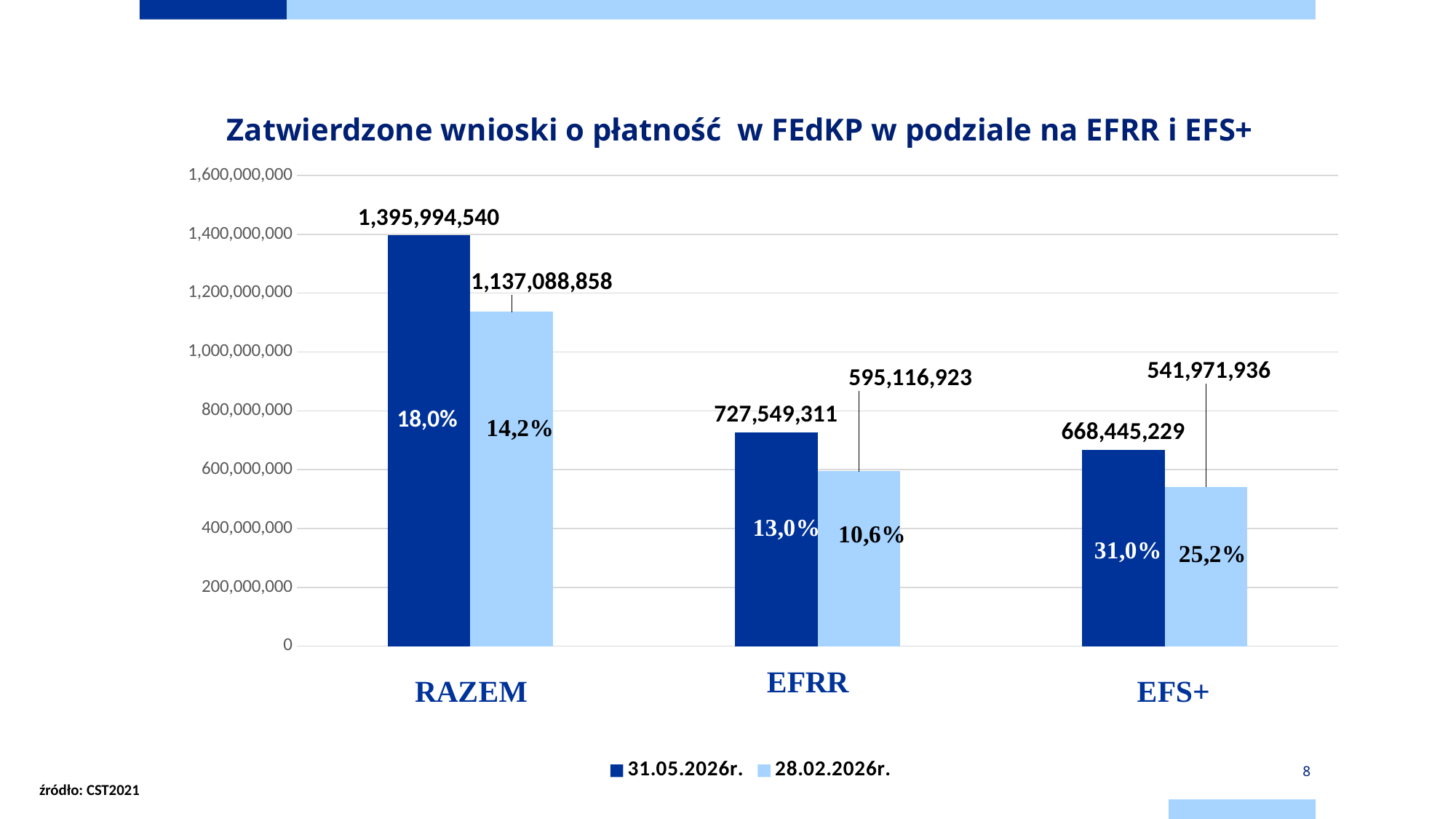
How many categories are shown on the x axis? 3 What percentage is shown inside the 28.02.2026r. bar for EFS+? 25,2% Which category has the lowest value in the 28.02.2026r. series? EFS+ What is the difference between the 31.05.2026r. and 28.02.2026r. values for EFRR? 132,432,388 What is the value for EFS+ in the 31.05.2026r. series? 668,445,229 Which is larger: the 31.05.2026r. value for EFRR or the 31.05.2026r. value for EFS+? EFRR How many series does the legend list? 2 What is the value for RAZEM in the 31.05.2026r. series? 1,395,994,540 What is the value for EFRR in the 28.02.2026r. series? 595,116,923 What type of chart is shown on the slide? bar chart What is the difference between the 31.05.2026r. and 28.02.2026r. values for RAZEM? 258,905,682 Which category has the highest value in the 31.05.2026r. series? RAZEM